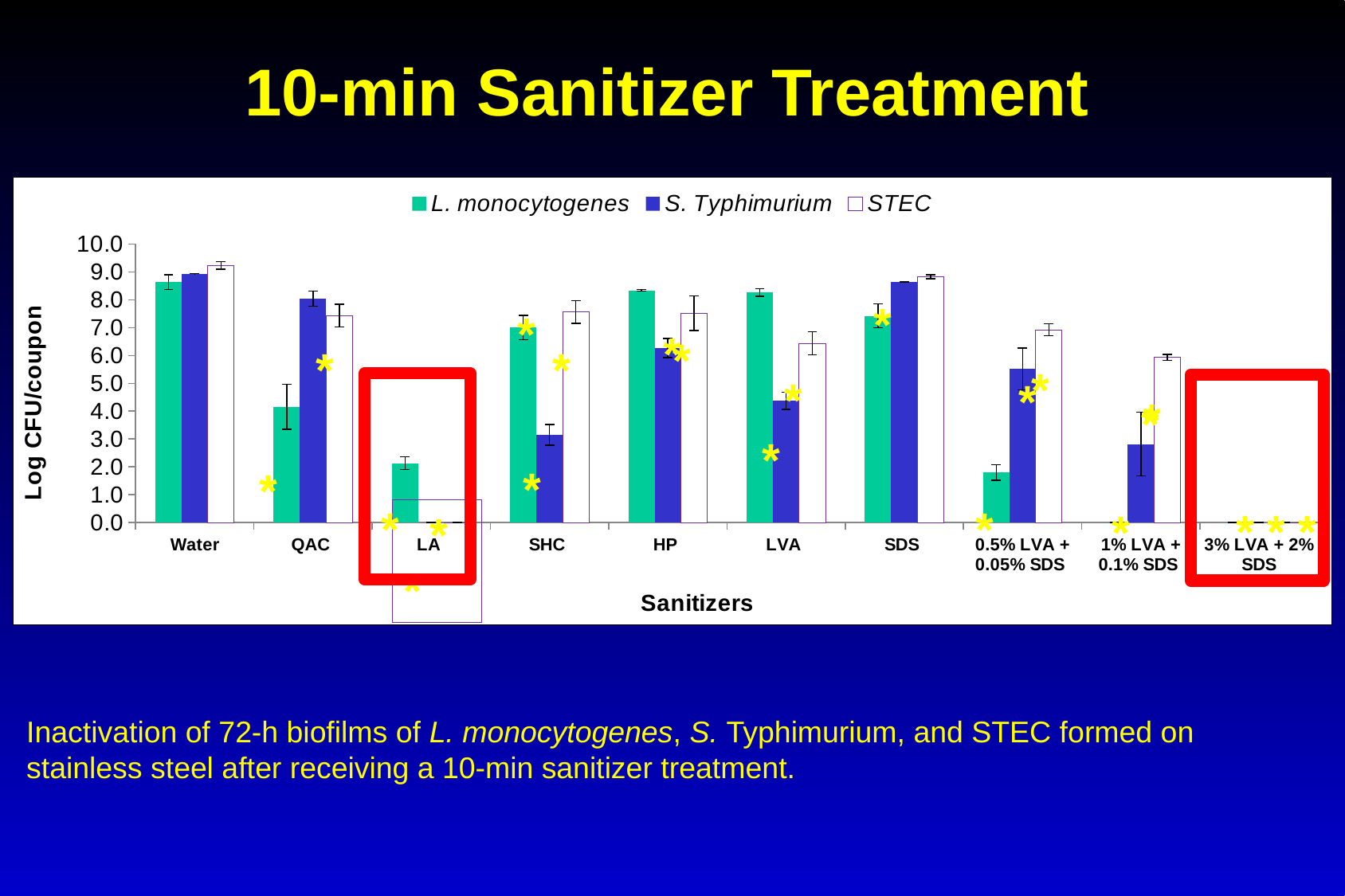
Is the S. Typhimurium value for LA greater or less than 1.0? less Which is larger, the S. Typhimurium value for QAC or for SHC? QAC Which sanitizer has the highest L. monocytogenes value? Water How many sanitizer categories are shown on the x axis? 10 Is the S. Typhimurium value for LVA greater or less than 5.0? less Is the STEC value for 1% LVA + 0.1% SDS greater or less than 5.0? greater What is the label of the y axis? Log CFU/coupon How many series does the legend list? 3 Which is larger, the STEC value for LVA or for SDS? SDS What kind of chart is shown on the slide? bar chart